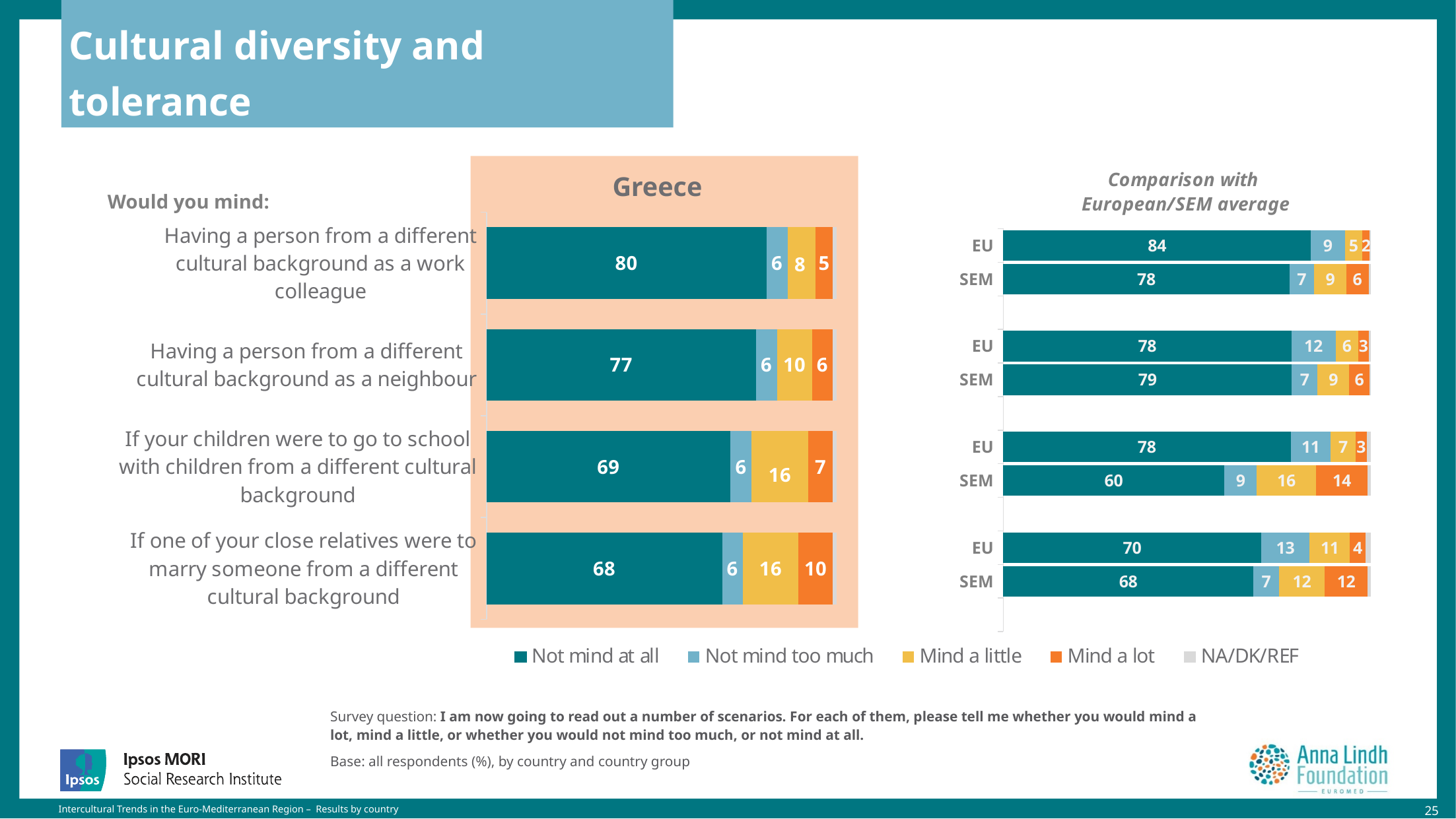
In the Greece chart, what is the difference between the 'Not mind at all' values for the work colleague scenario and the close relative marrying scenario? 12 In the Comparison with European/SEM average chart, what is the SEM 'Not mind at all' value for the children at school scenario? 60 In the Comparison with European/SEM average chart, what is the difference between the EU and SEM 'Not mind at all' values for the children at school scenario? 18 How many scenarios are plotted in the Greece chart? 4 What is the title of the chart on the right side of the slide? Comparison with European/SEM average In the Greece chart, which scenario has the lowest 'Not mind at all' value? If one of your close relatives were to marry someone from a different cultural background In the Greece chart, which scenario has the highest 'Not mind at all' value? Having a person from a different cultural background as a work colleague In the Greece chart, what percentage would not mind at all having a person from a different cultural background as a work colleague? 80 What kind of chart is the Greece chart? Stacked bar chart In the Greece chart, what percentage would mind a lot if one of their close relatives were to marry someone from a different cultural background? 10 In the Greece chart, is the 'Mind a little' value larger for the children at school scenario or the neighbour scenario? If your children were to go to school with children from a different cultural background How many series does the legend list? 5